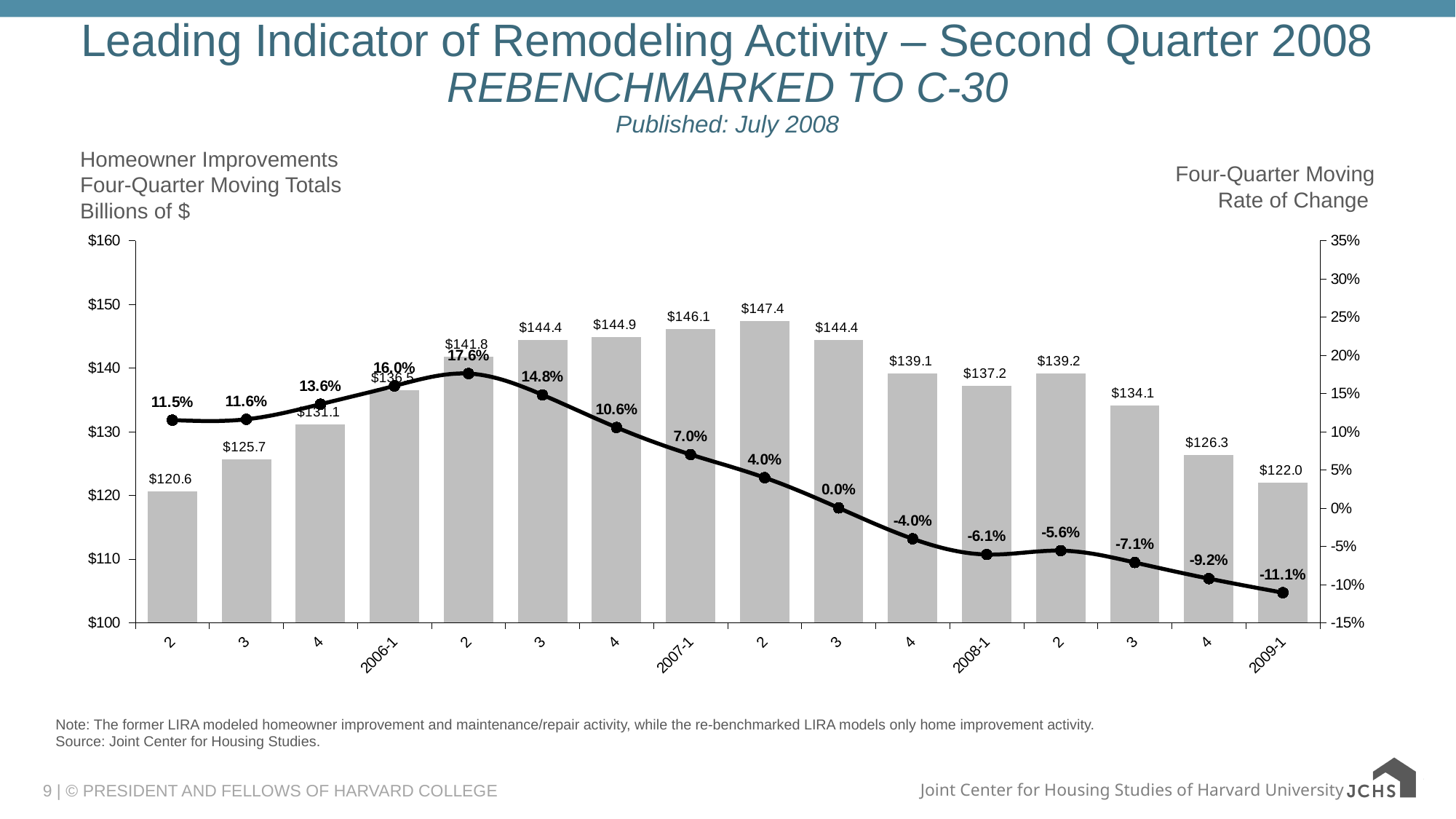
What kind of chart is this? A bar chart combined with a line chart Does the rate of change line rise or fall from 2007-1 to 2009-1? Fall What is the lowest four-quarter moving total shown by any bar? $120.6 What is the four-quarter moving rate of change for 2009-1? -11.1% What is the highest four-quarter moving total shown by any bar? $147.4 What is the four-quarter moving total (bar) for 2007-1? $146.1 What is the highest four-quarter moving rate of change shown on the line? 17.6% How much larger is the four-quarter moving total for 2008-1 than for 2009-1? $15.2 What is the four-quarter moving rate of change (line) for 2008-1? -6.1% How many bars (quarters) are plotted on the chart? 16 Which has the larger four-quarter moving total, 2006-1 or 2009-1? 2006-1 By how many percentage points does the rate of change fall from 2006-1 to 2007-1? 9.0 percentage points